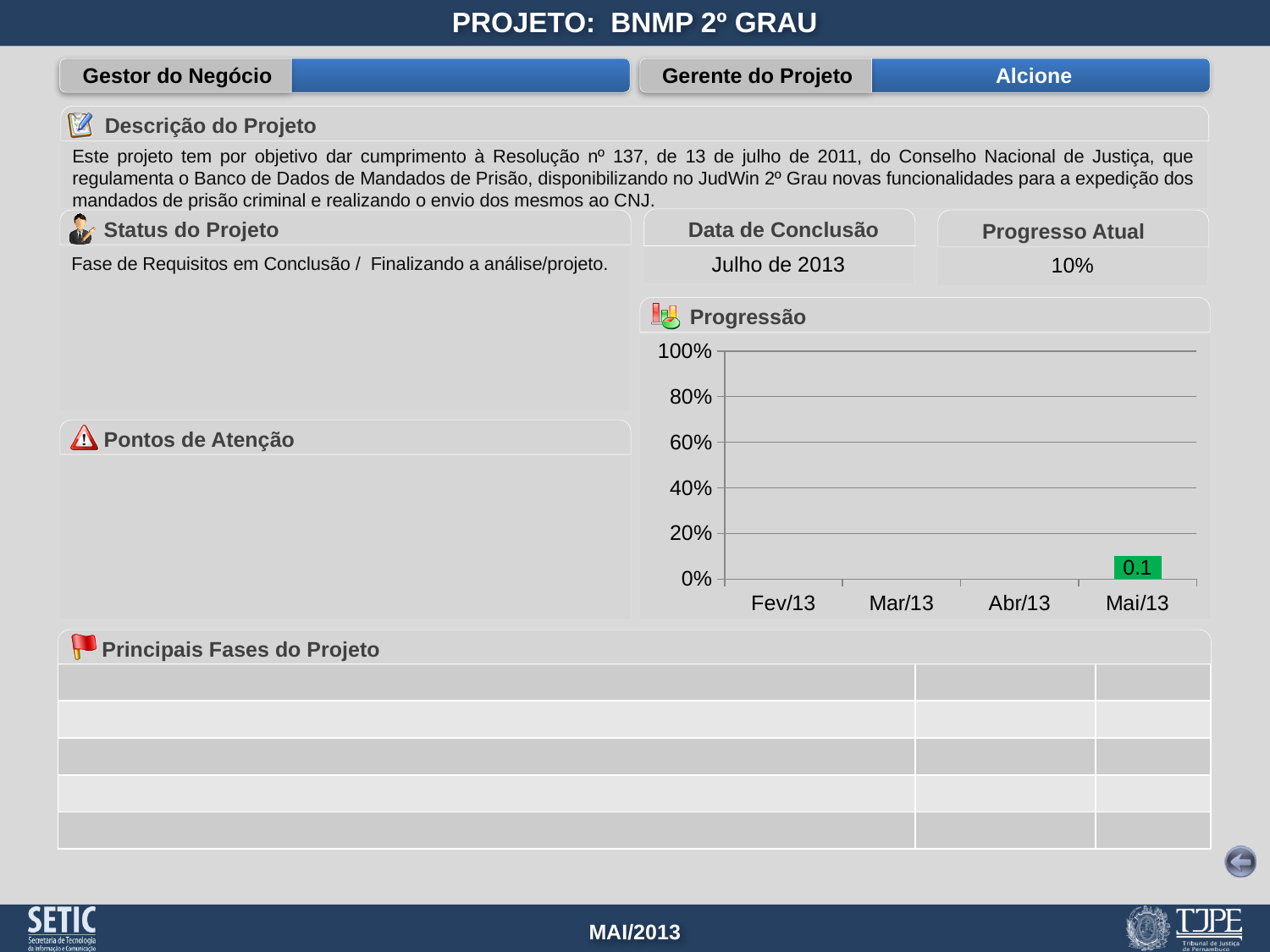
What kind of chart is shown under the heading "Progressão"? bar chart What is the data label on the bar for Mai/13 in the Progressão chart? 0.1 How many categories are shown on the x axis of the Progressão chart? 4 What is the first category on the x axis of the Progressão chart? Fev/13 What is the highest tick value shown on the y axis of the Progressão chart? 100% Which category in the Progressão chart has the highest value? Mai/13 How many categories in the Progressão chart have a visible bar? 1 Is the value for Mai/13 in the Progressão chart greater or less than 20%? less